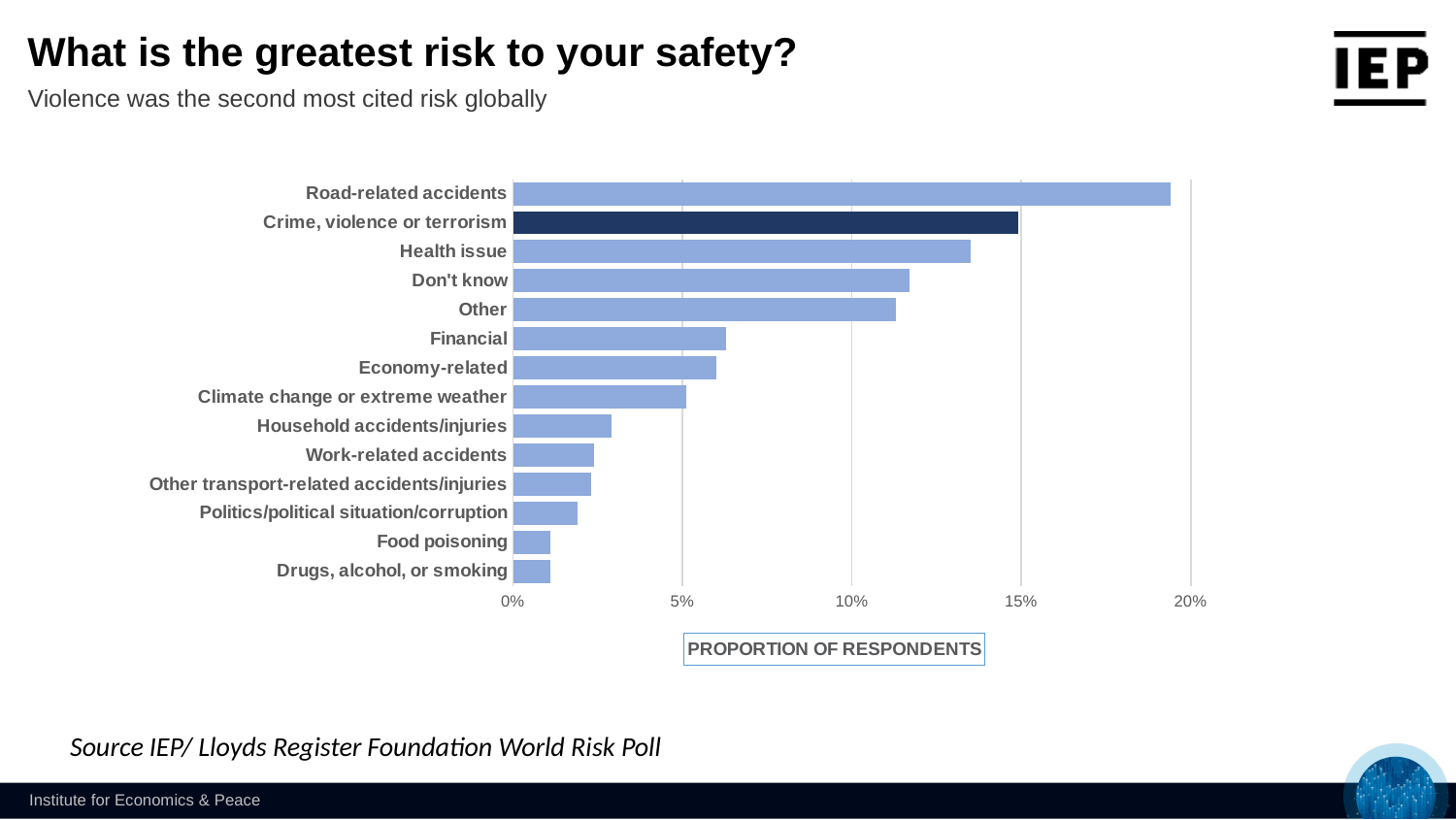
Is the value for Don't know greater or less than 10%? greater How many categories are shown in the chart? 14 Is the value for Household accidents/injuries greater or less than 5%? less Which is larger, the value for Health issue or the value for Other? Health issue Is the value for Road-related accidents greater or less than 15%? greater What kind of chart is shown on the slide? bar chart Which category has the highest proportion of respondents? Road-related accidents What is the label on the horizontal axis of the chart? PROPORTION OF RESPONDENTS Which category's bar is shown in a darker colour than the others? Crime, violence or terrorism Which is larger, the value for Climate change or extreme weather or the value for Politics/political situation/corruption? Climate change or extreme weather